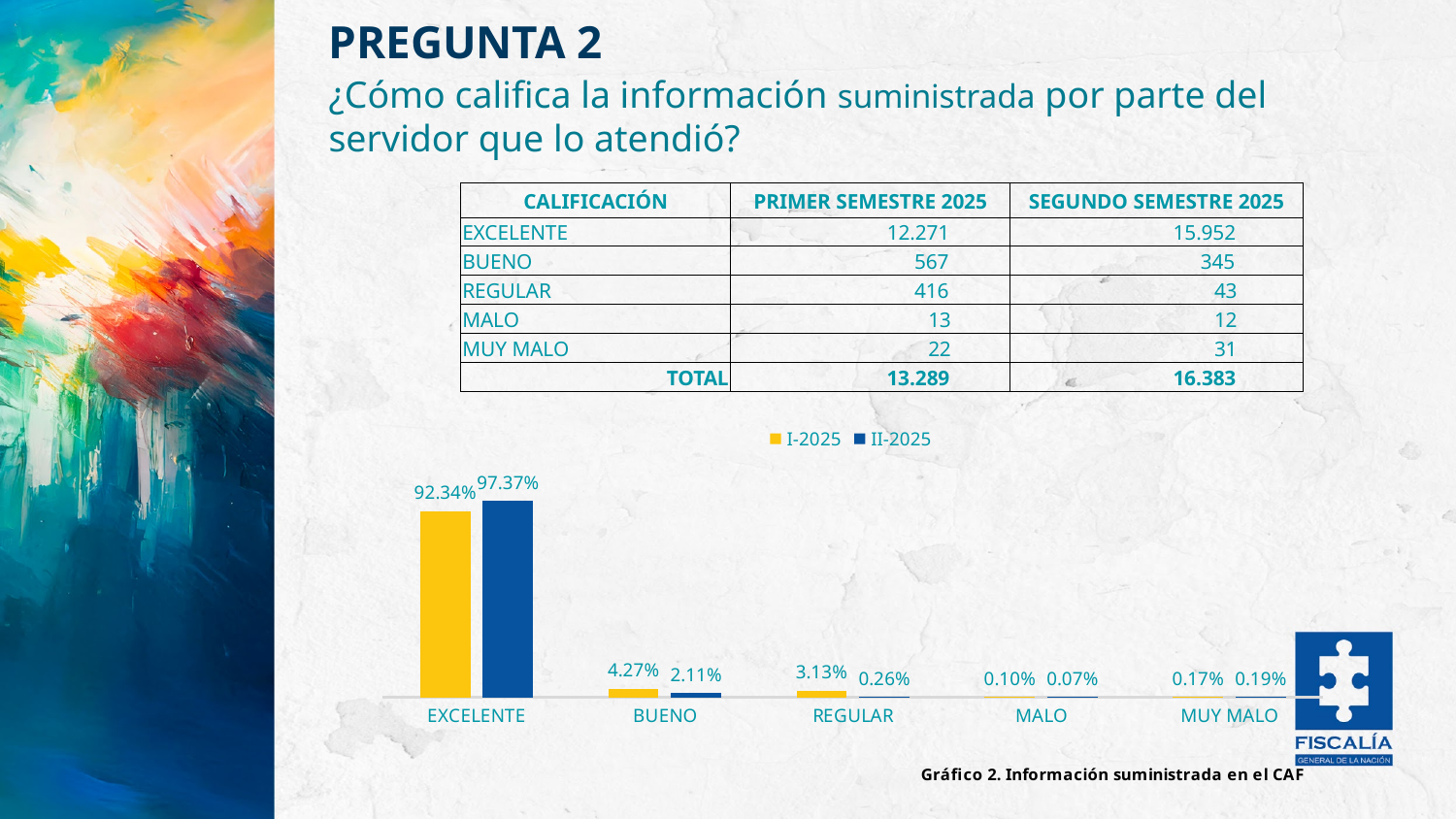
What is the value for REGULAR in the I-2025 series? 3.13% How many series does the chart legend list? 2 What is the value for BUENO in the II-2025 series? 2.11% Which category has the highest value in the II-2025 series? EXCELENTE Which category has the lowest value in the I-2025 series? MALO What type of chart is shown on the slide? bar chart How many categories are shown on the x axis of the chart? 5 What is the value for EXCELENTE in the II-2025 series? 97.37% For REGULAR, which series has the larger value, I-2025 or II-2025? I-2025 What is the value for EXCELENTE in the I-2025 series? 92.34% What is the value for MUY MALO in the II-2025 series? 0.19% What is the difference between the II-2025 and I-2025 values for EXCELENTE? 5.03%